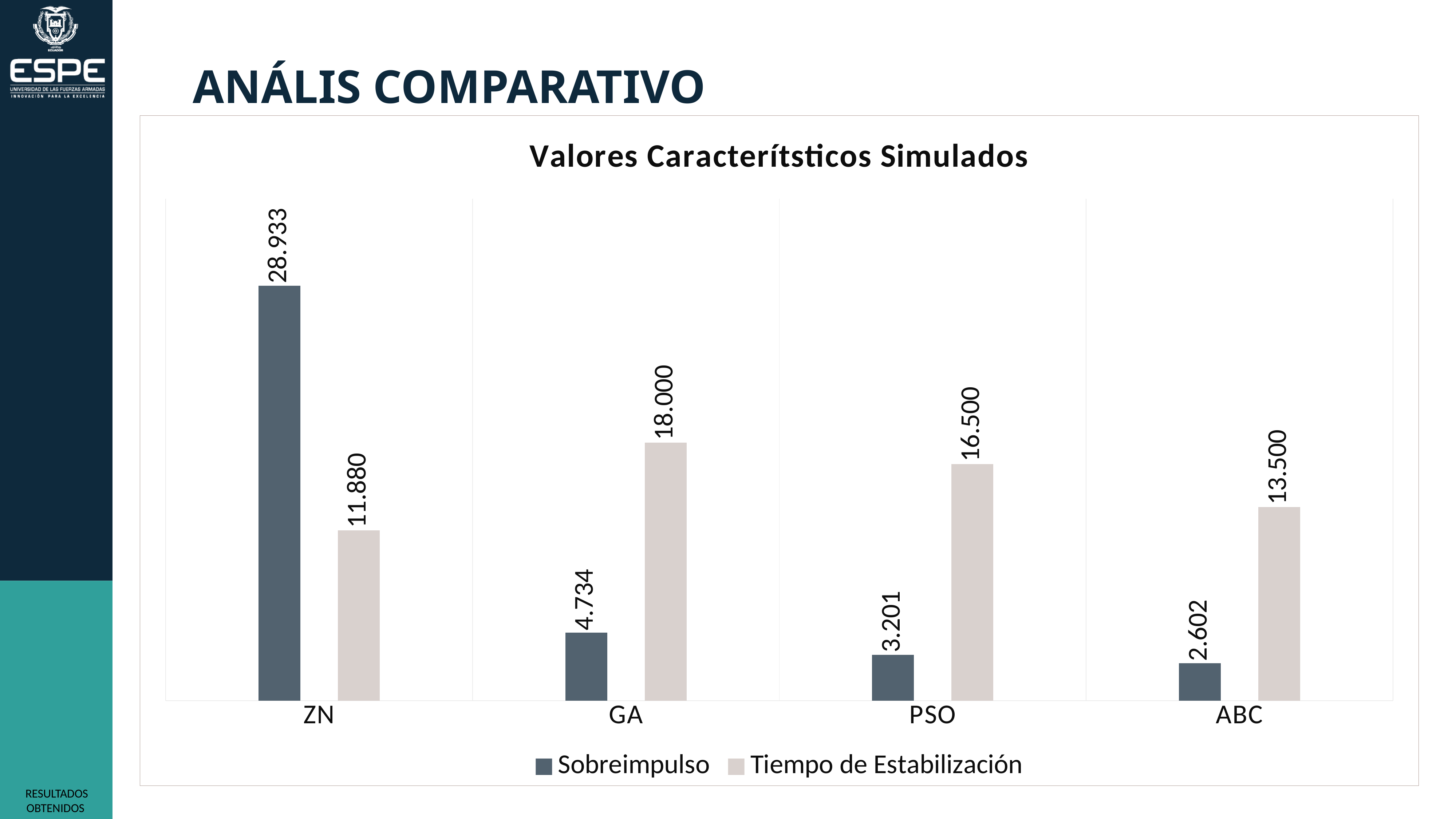
Which category has the highest Sobreimpulso value? ZN What is the Tiempo de Estabilización value for ABC? 13.500 How many categories are shown on the x axis? 4 How many series does the legend list? 2 What is the Sobreimpulso value for PSO? 3.201 What is the Sobreimpulso value for ZN? 28.933 What is the Tiempo de Estabilización value for GA? 18.000 Which is larger: the Sobreimpulso value for GA or the Sobreimpulso value for PSO? GA What kind of chart is shown on the slide? Bar chart Which category has the lowest Sobreimpulso value? ABC What is the difference between the Tiempo de Estabilización values for GA and PSO? 1.500 Which category has the lowest Tiempo de Estabilización value? ZN